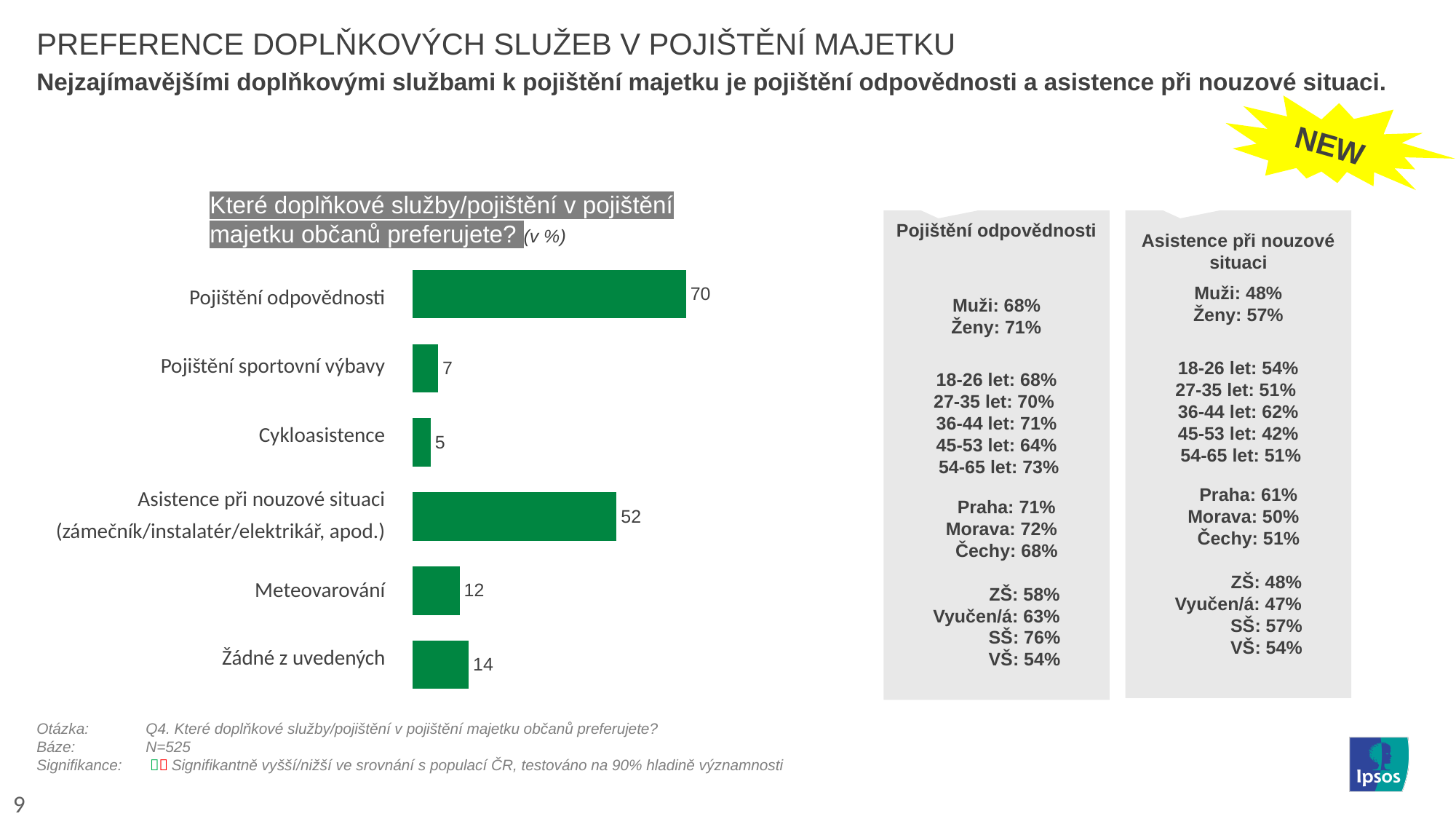
What is the value for Asistence při nouzové situaci (zámečník/instalatér/elektrikář, apod.)? 52 What kind of chart is shown on the slide? Bar chart What is the difference between the values for Žádné z uvedených and Cykloasistence? 9 How many categories does the bar chart show? 6 What is the value for Meteovarování? 12 What is the difference between the values for Pojištění odpovědnosti and Asistence při nouzové situaci? 18 Which category has the lowest value? Cykloasistence Which category has the highest value? Pojištění odpovědnosti Which is larger, the value for Pojištění sportovní výbavy or the value for Meteovarování? Meteovarování What is the value for Pojištění odpovědnosti? 70 What colour are the bars in the chart? Green What is the value for Žádné z uvedených? 14